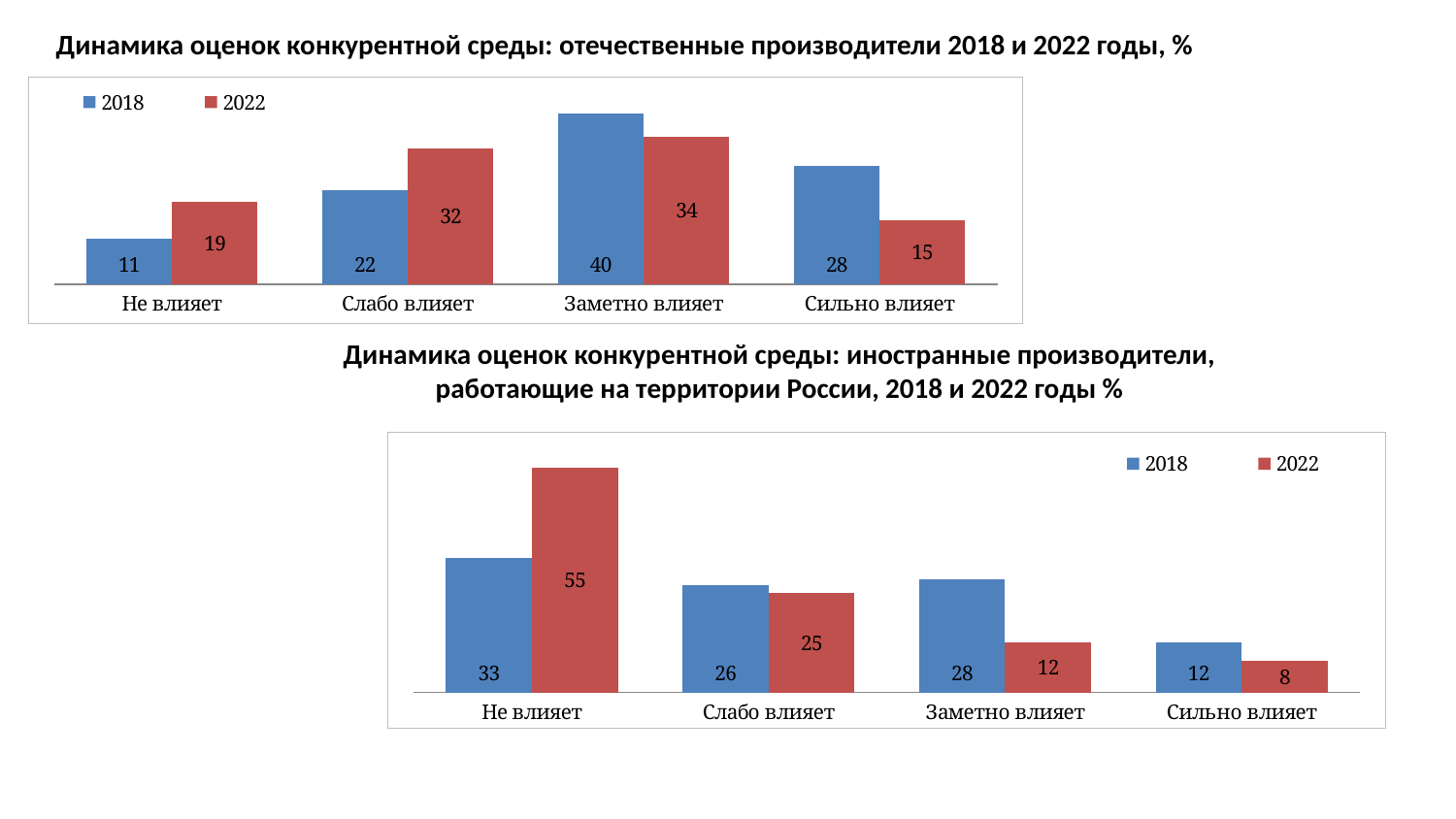
In the top chart (отечественные производители), which category has the lowest 2018 value? Не влияет In the top chart (отечественные производители), which category has the highest 2022 value? Заметно влияет In the top chart (отечественные производители), what is the difference between the 2022 and 2018 values for 'Слабо влияет'? 10 In the bottom chart (иностранные производители), which is larger for 'Заметно влияет': the 2018 value or the 2022 value? 2018 In the top chart (отечественные производители), what is the 2018 value for 'Заметно влияет'? 40 In the bottom chart (иностранные производители), which category has the lowest 2022 value? Сильно влияет In the top chart (отечественные производители), how many categories are shown on the x axis? 4 In the bottom chart (иностранные производители), what is the difference between the 2022 and 2018 values for 'Не влияет'? 22 How many series does the legend of the bottom chart (иностранные производители) list? 2 In the bottom chart (иностранные производители), what is the 2018 value for 'Заметно влияет'? 28 In the bottom chart (иностранные производители), what is the 2022 value for 'Не влияет'? 55 In the top chart (отечественные производители), what is the 2022 value for 'Сильно влияет'? 15